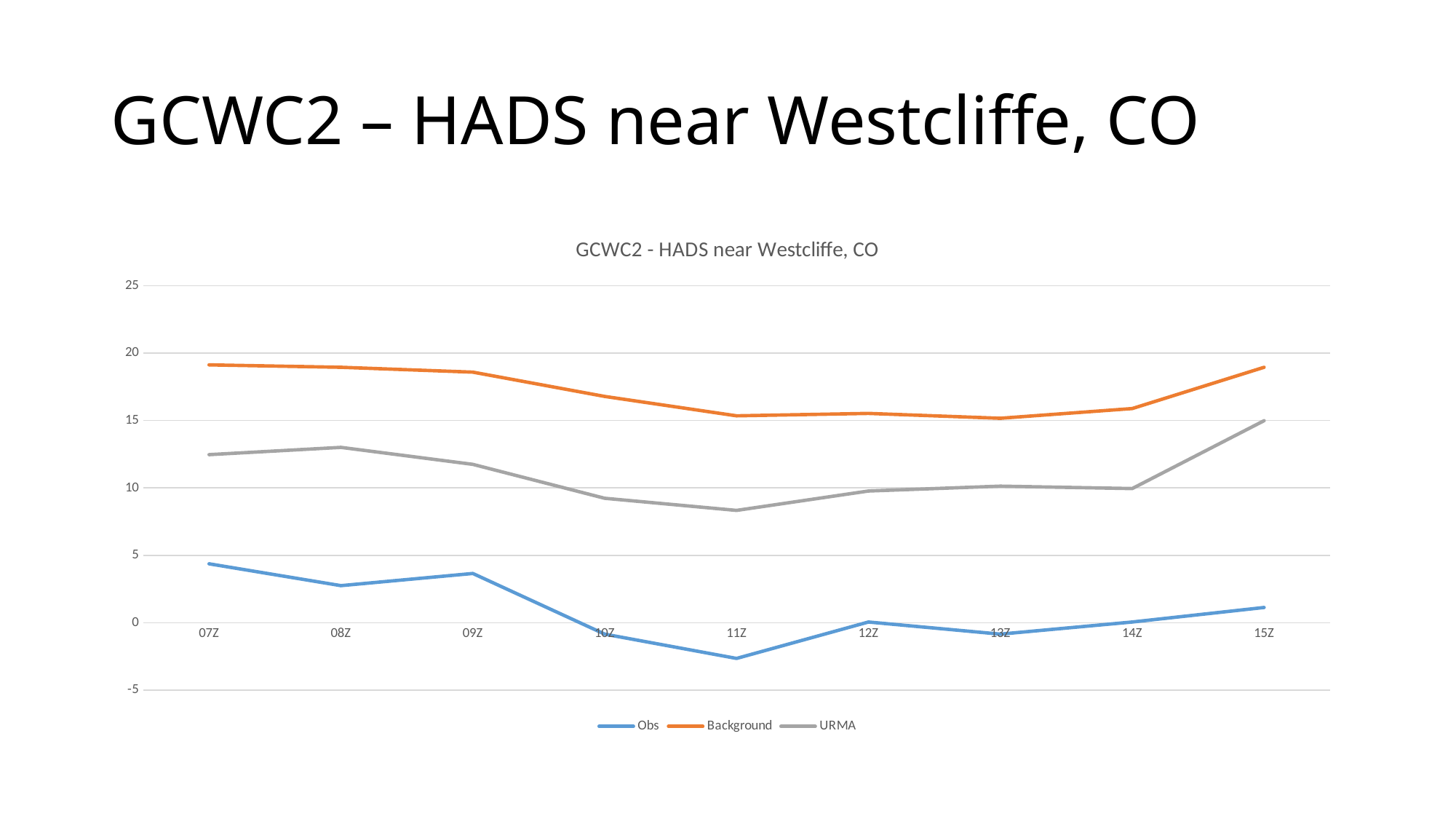
Which series has the larger value at 07Z, Background or URMA? Background What is the title of the chart? GCWC2 - HADS near Westcliffe, CO At which time is the URMA series lowest? 11Z What kind of chart is shown on the slide? line chart At which time is the URMA series highest? 15Z Is the URMA value at 11Z greater or less than 10? less Is the Background value at 07Z greater or less than 20? less How many time points are plotted along the x axis? 9 How many series does the legend list? 3 Does the Obs series rise or fall from 07Z to 11Z? fall Which series is plotted with the orange line? Background At which time is the Obs series lowest? 11Z